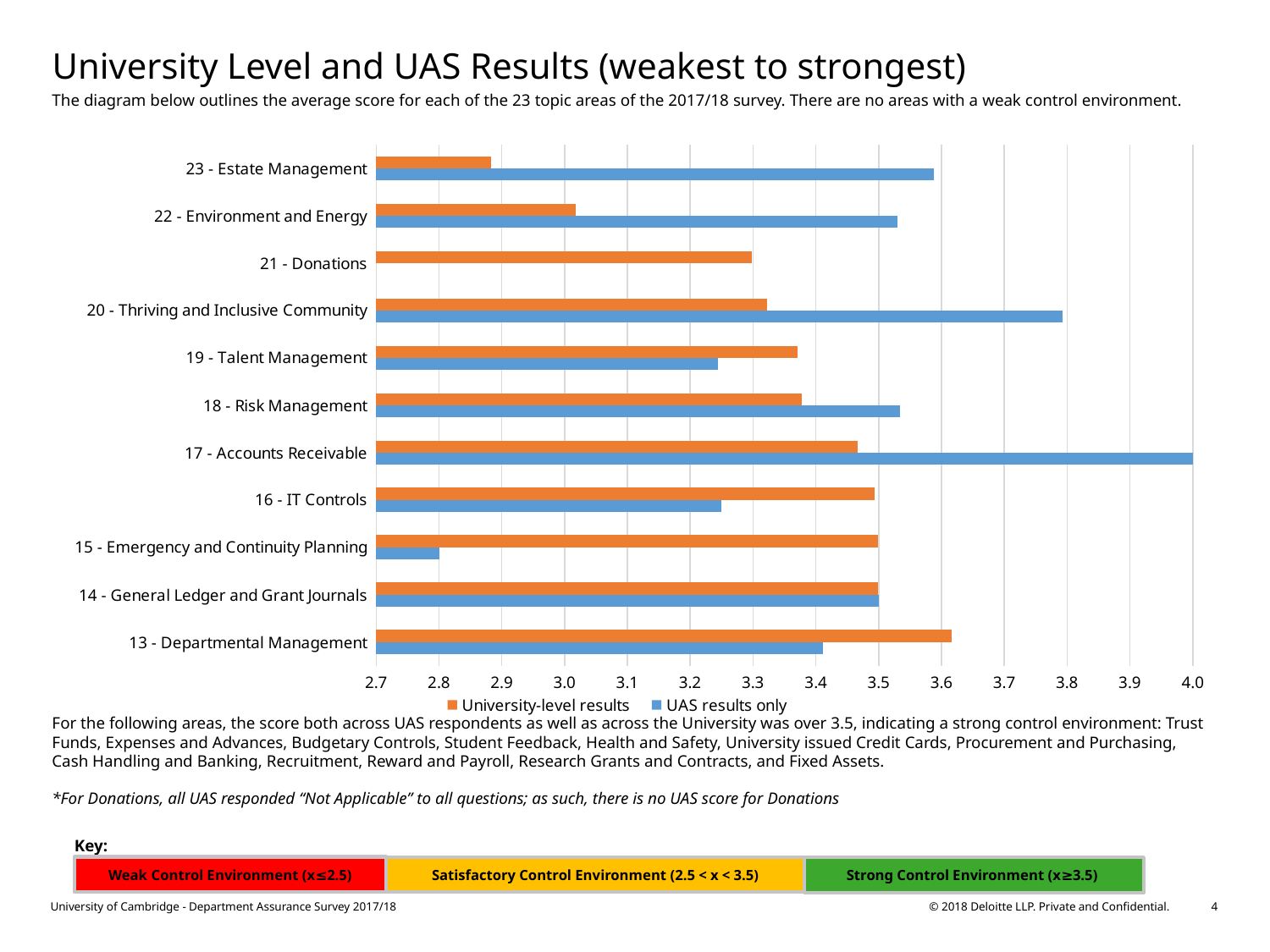
Is the UAS results only value for 13 - Departmental Management greater or less than 3.5? less Which topic area has the lowest UAS results only score? 15 - Emergency and Continuity Planning Which topic area has the lowest University-level results score? 23 - Estate Management How many series does the chart legend list? 2 For 19 - Talent Management, which series has the larger value: University-level results or UAS results only? University-level results Is the University-level results value for 23 - Estate Management greater or less than 2.9? less Which topic area has no UAS results only bar on the chart? 21 - Donations How many topic areas are plotted on the chart? 11 What type of chart is shown on the slide? bar chart Which topic area has the highest UAS results only score? 17 - Accounts Receivable Which topic area has the highest University-level results score? 13 - Departmental Management Is the UAS results only value for 20 - Thriving and Inclusive Community greater or less than 3.7? greater